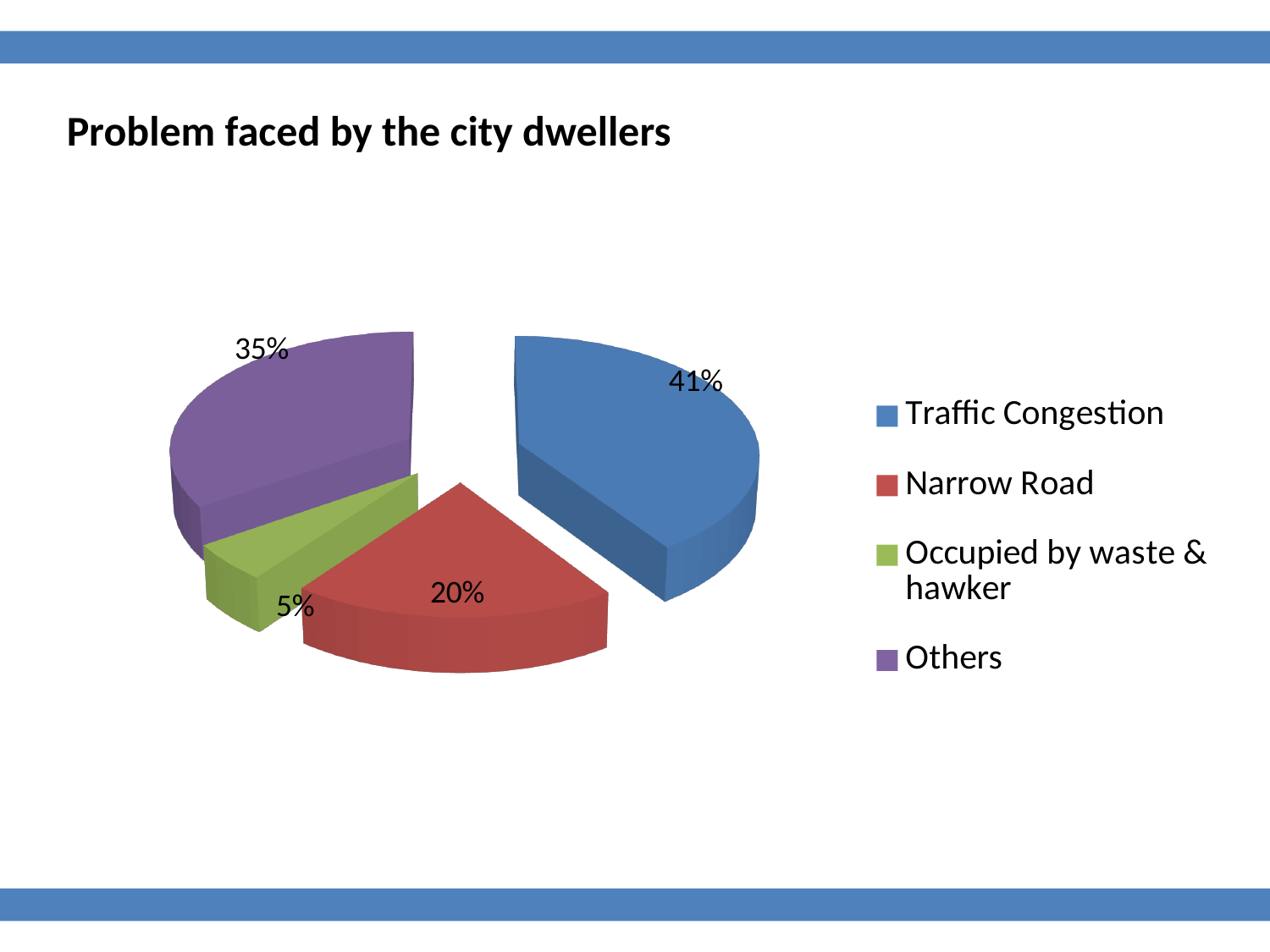
What share of the pie does Others represent? 35% What is the value shown for Occupied by waste & hawker? 5% What is the difference between the Traffic Congestion and Others percentages? 6% What colour is the slice for Narrow Road? Red What is the difference between the Narrow Road and Occupied by waste & hawker percentages? 15% What is the value shown for Narrow Road? 20% What share of the pie does Traffic Congestion represent? 41% How many categories are shown in the pie chart? 4 What kind of chart is shown on the slide? Pie chart Which category has the smallest slice of the pie? Occupied by waste & hawker Which is larger, Narrow Road or Others? Others Which category has the largest slice of the pie? Traffic Congestion